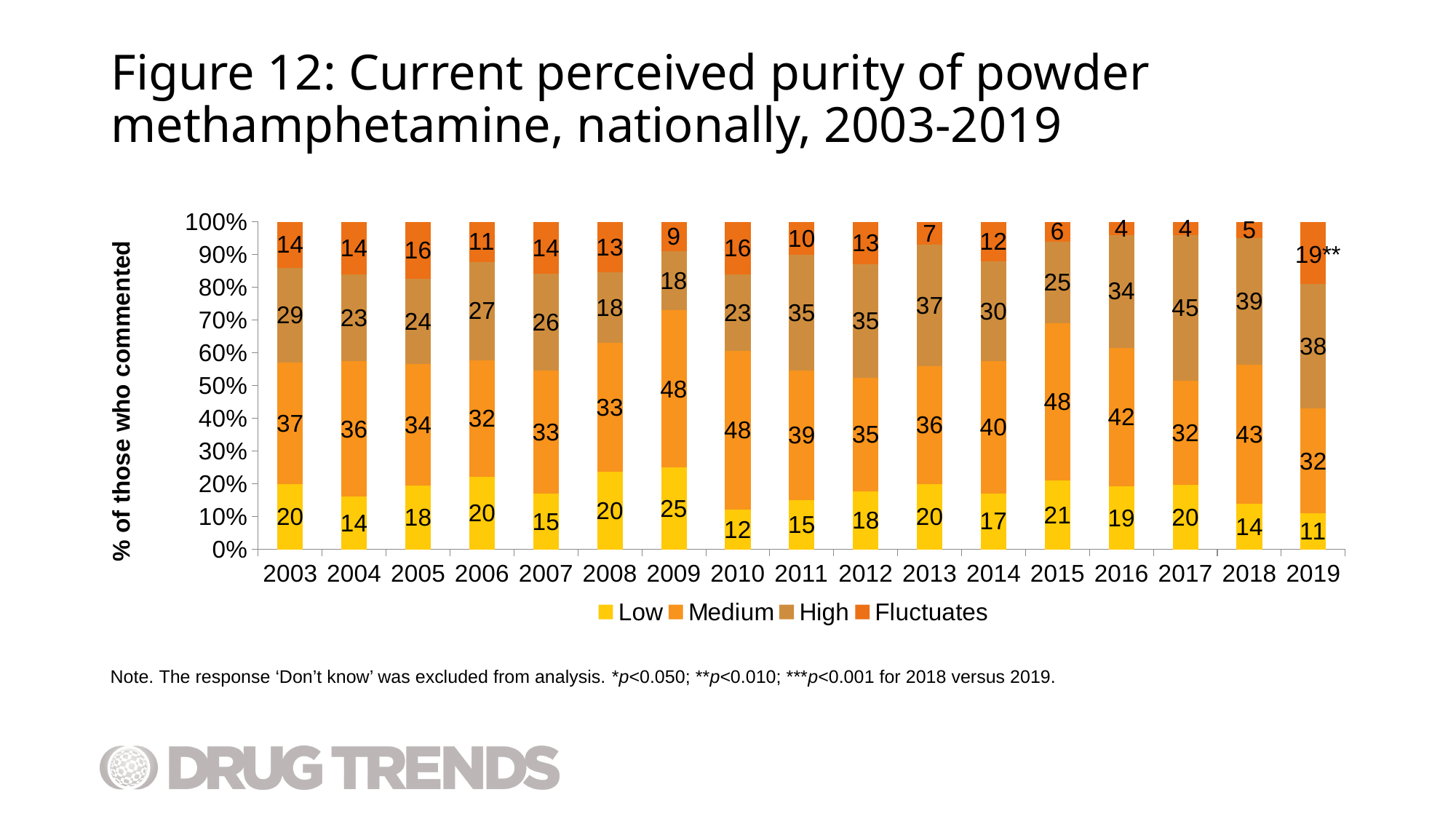
What is the difference between the Medium value in 2015 and the Medium value in 2017? 16 What kind of chart is shown on the slide? Stacked bar chart What is the value for Medium in 2010? 48 In which year is the High segment the largest? 2017 What is the label of the y axis? % of those who commented In which year is the Low segment the smallest? 2019 What percentage of those who commented rated purity as Low in 2009? 25 How many series does the legend list? 4 What is the value for Fluctuates in 2019? 19 What is the value for High in 2017? 45 Which is larger in 2013, the High segment or the Medium segment? High How many years are shown on the x axis? 17